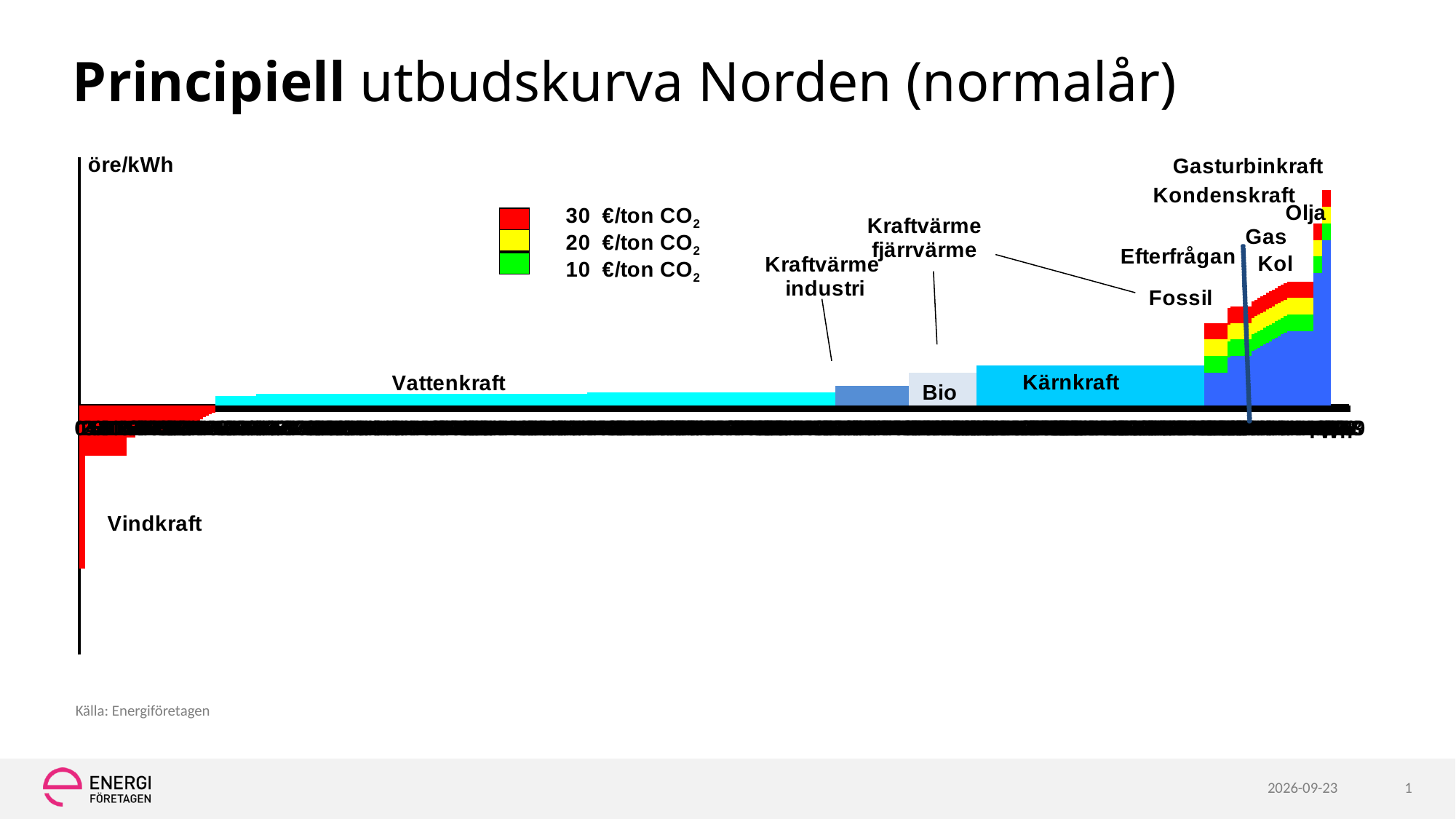
Which colour in the legend represents 30 €/ton CO2? Red How many CO2 price levels does the legend list? 3 What unit is shown on the vertical axis of the chart? öre/kWh Do the values of the supply curve rise or fall from left to right? Rise Is Kol plotted higher or lower on the curve than Olja? Lower Which technology is at the highest point of the supply curve? Gasturbinkraft Is Kärnkraft plotted higher or lower on the curve than Vattenkraft? Higher Which technology is plotted below the horizontal axis, with a negative value? Vindkraft Which is plotted higher on the curve, Fossil or Bio? Fossil